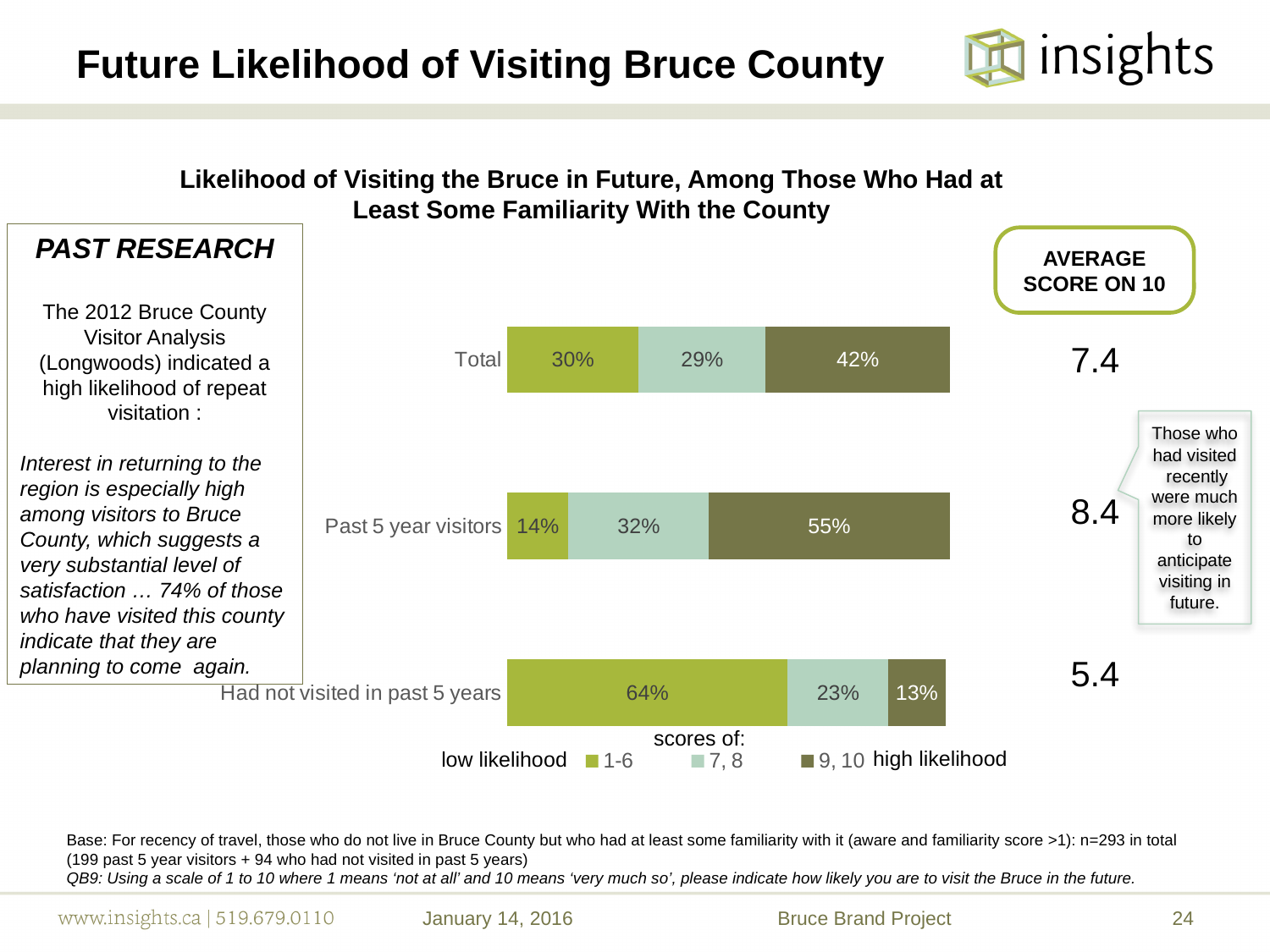
Which category has the highest share of scores of 9, 10? Past 5 year visitors What percentage of those who had not visited in past 5 years gave a score of 1-6? 64% What is the difference between the 9, 10 share for Past 5 year visitors and for those who had not visited in past 5 years? 42 percentage points How many series does the legend list? 3 What type of chart is shown on the slide? stacked bar chart What is the average score on 10 shown for Past 5 year visitors? 8.4 What percentage of Past 5 year visitors gave a score of 9 or 10? 55% How many categories (bars) are shown in the chart? 3 What percentage of those who had not visited in past 5 years gave a score of 9 or 10? 13% Which is larger: the 1-6 share for Total or the 1-6 share for Past 5 year visitors? Total Which category has the lowest share of scores of 1-6? Past 5 year visitors What percentage of the Total group gave a score of 7 or 8? 29%